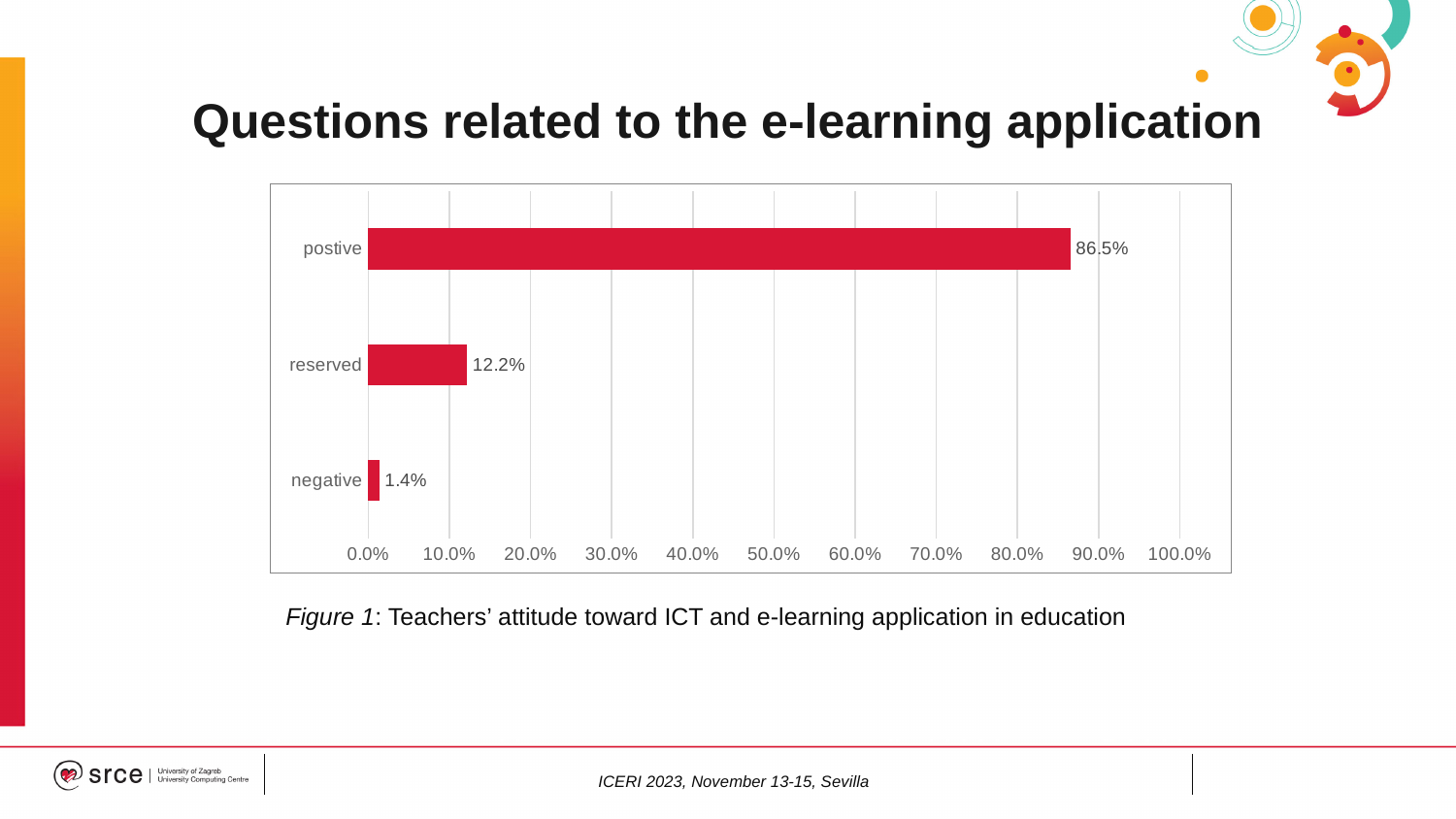
Is the value for "postive" greater or less than 80.0%? greater Which is larger, the value for "reserved" or the value for "negative"? reserved What is the value for the "reserved" category? 12.2% What is the difference between the "reserved" and "negative" values? 10.8% Which category has the highest value? postive What is the value for the "postive" category? 86.5% What kind of chart is shown on the slide? bar chart How many categories are shown in the chart? 3 What is the caption of the figure below the chart? Figure 1: Teachers' attitude toward ICT and e-learning application in education What is the value for the "negative" category? 1.4% Which category has the lowest value? negative What is the difference between the "postive" and "reserved" values? 74.3%